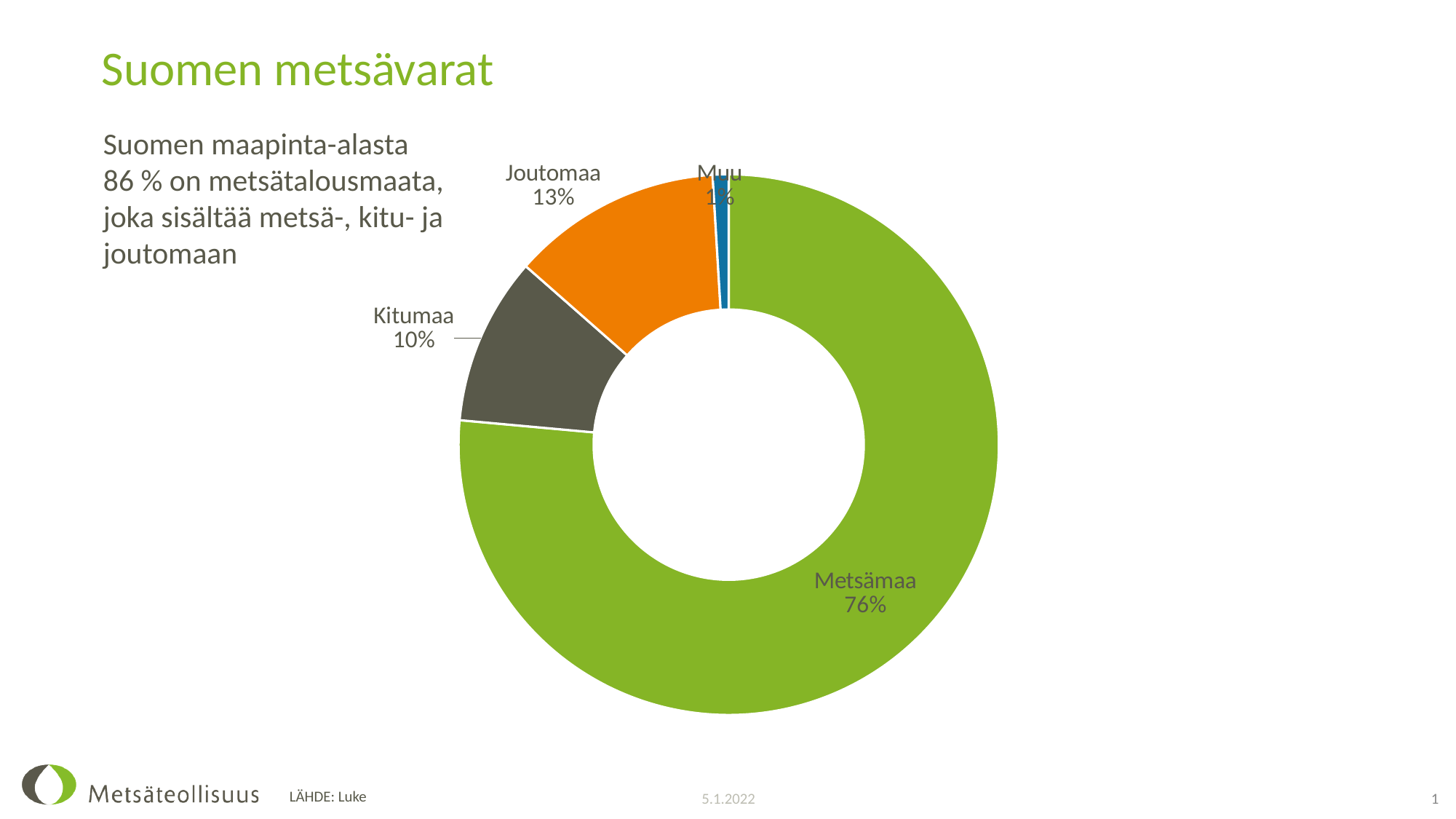
What share of the pie does Kitumaa have? 10% Which is larger, the share for Joutomaa or the share for Kitumaa? Joutomaa What is the title of the slide containing the chart? Suomen metsävarat What share of the pie does Metsämaa have? 76% What kind of chart is shown on the slide? Pie chart (doughnut) What colour is the Metsämaa slice? Green What is the difference in percentage points between Joutomaa and Kitumaa? 3 How many categories are shown in the pie chart? 4 What share of the pie does Muu have? 1% Which category has the smallest share of the pie? Muu What share of the pie does Joutomaa have? 13% Which category has the largest share of the pie? Metsämaa